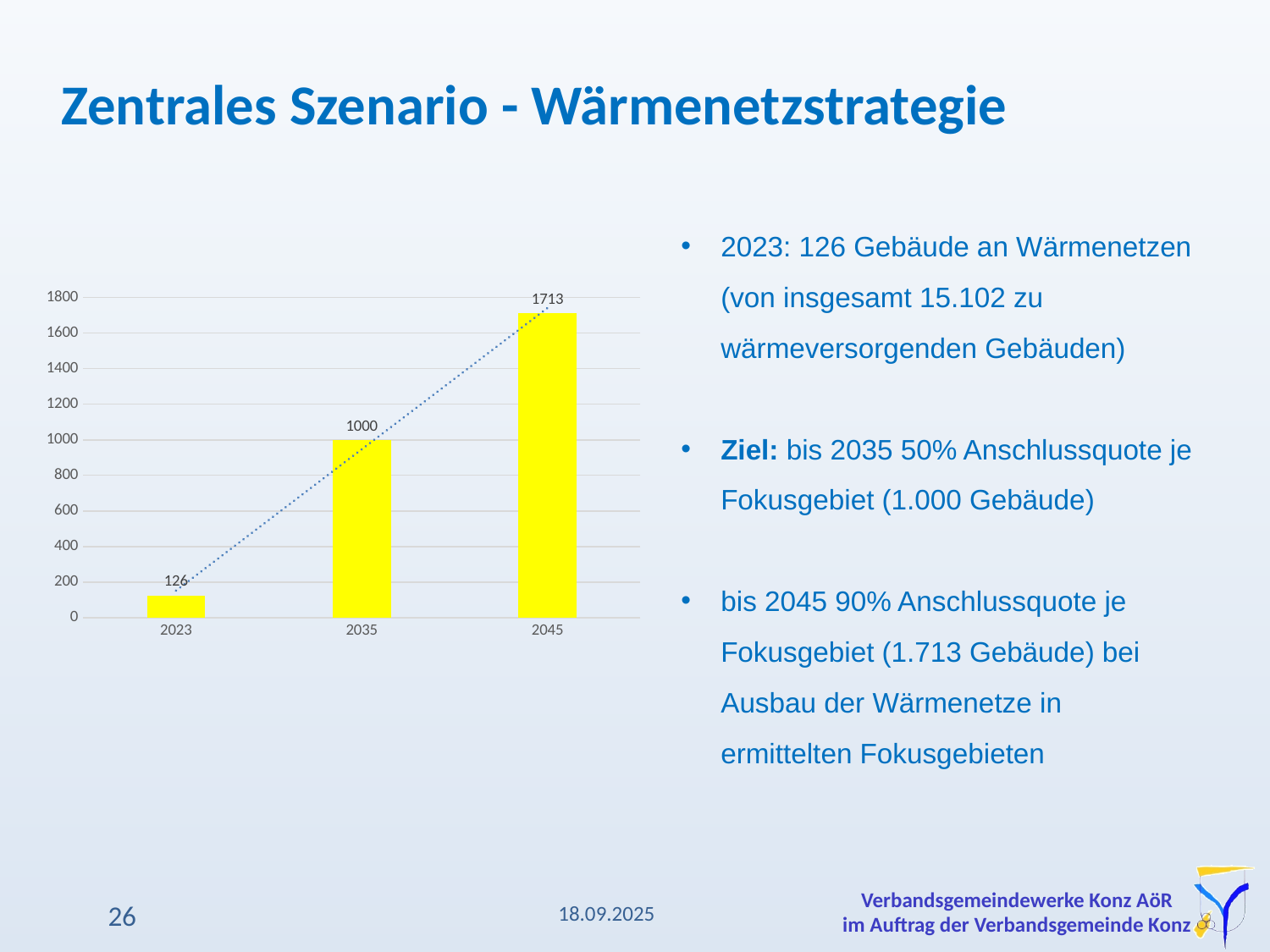
What is the difference between the values for 2035 and 2023? 874 What is the value for 2045? 1713 How many years are shown on the x axis? 3 Which year has the lowest value? 2023 What is the difference between the values for 2045 and 2035? 713 Which is larger, the value for 2035 or the value for 2023? 2035 What kind of chart is shown on the slide? bar chart What is the value for 2023? 126 Which year has the highest value? 2045 Do the values rise or fall from 2023 to 2045? rise Is the value for 2045 greater or less than 1600? greater What is the value for 2035? 1000